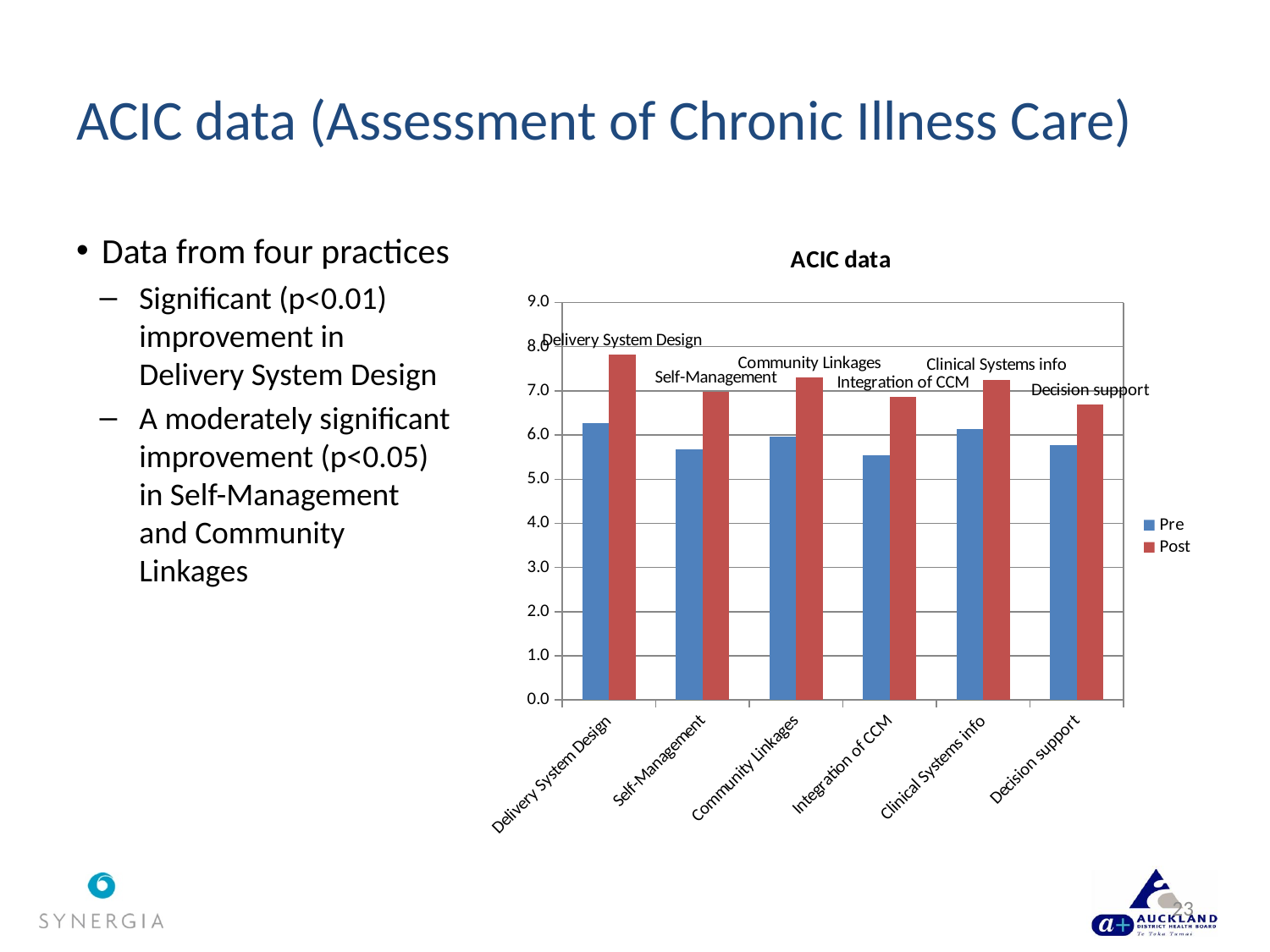
Which category has the highest Post value? Delivery System Design What kind of chart is shown on the slide? bar chart Which category has the lowest Pre value? Integration of CCM What is the title of the chart? ACIC data What are the two series named in the legend? Pre and Post How many categories are shown on the x axis of the chart? 6 Is the Post value for Delivery System Design greater or less than 7.0? greater For Delivery System Design, which is larger, the Pre value or the Post value? Post Is the Pre value for Integration of CCM greater or less than 6.0? less Is the Pre value for Delivery System Design greater or less than 6.0? greater How many series does the chart's legend list? 2